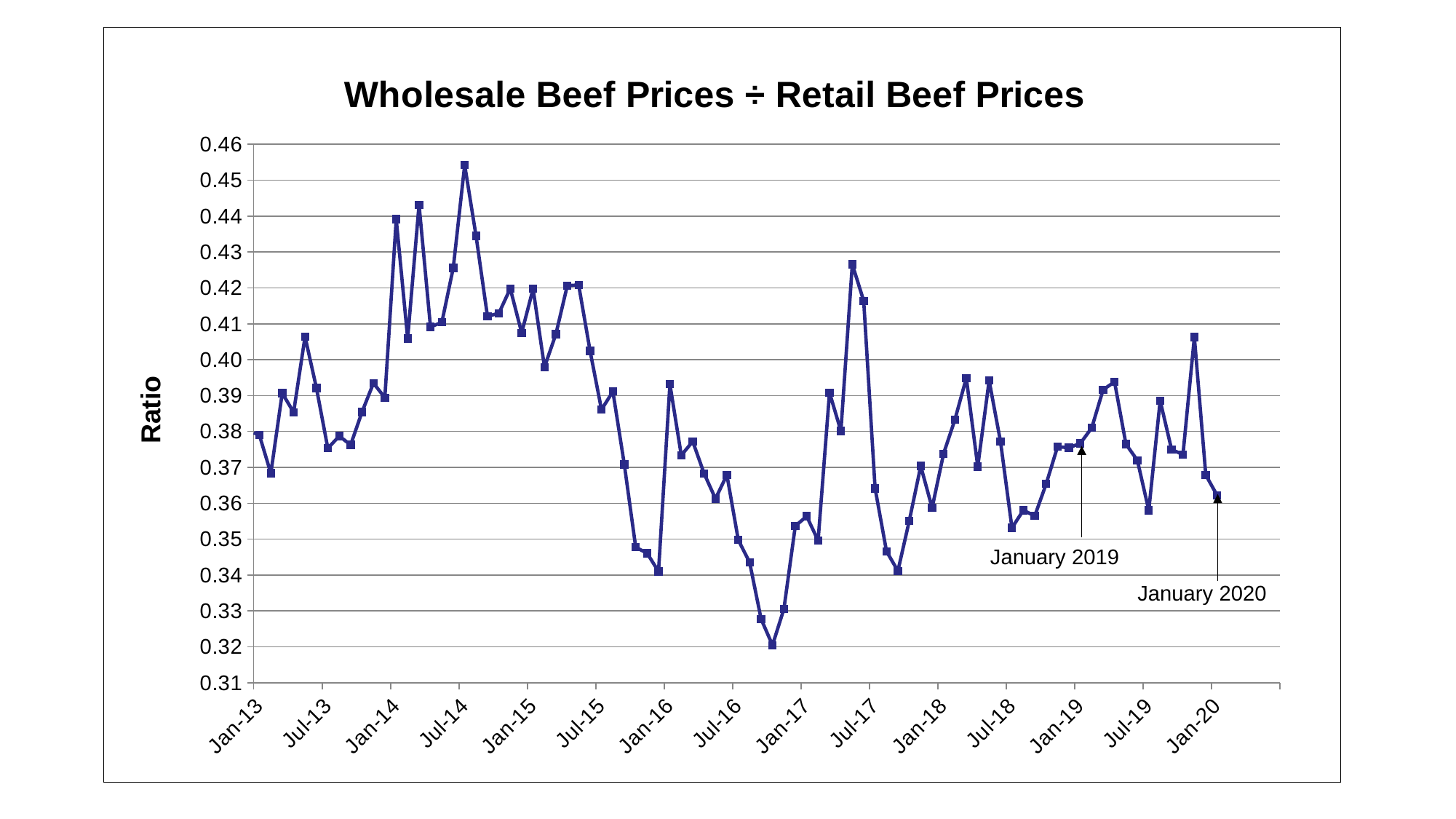
What is the title of the chart? Wholesale Beef Prices ÷ Retail Beef Prices Is the lowest value on the chart greater or less than 0.33? less Is the value at the point marked January 2019 greater or less than 0.37? greater What kind of chart is shown on the slide? line chart Which is larger, the value at the point marked January 2019 or the value at the point marked January 2020? January 2019 What is the label on the vertical axis? Ratio In which year does the highest value on the chart occur? 2014 Does the ratio rise or fall between its peak in mid-2014 and Jan-16? fall Is the value for Jan-16 greater or less than 0.35? greater In which year does the lowest value on the chart occur? 2016